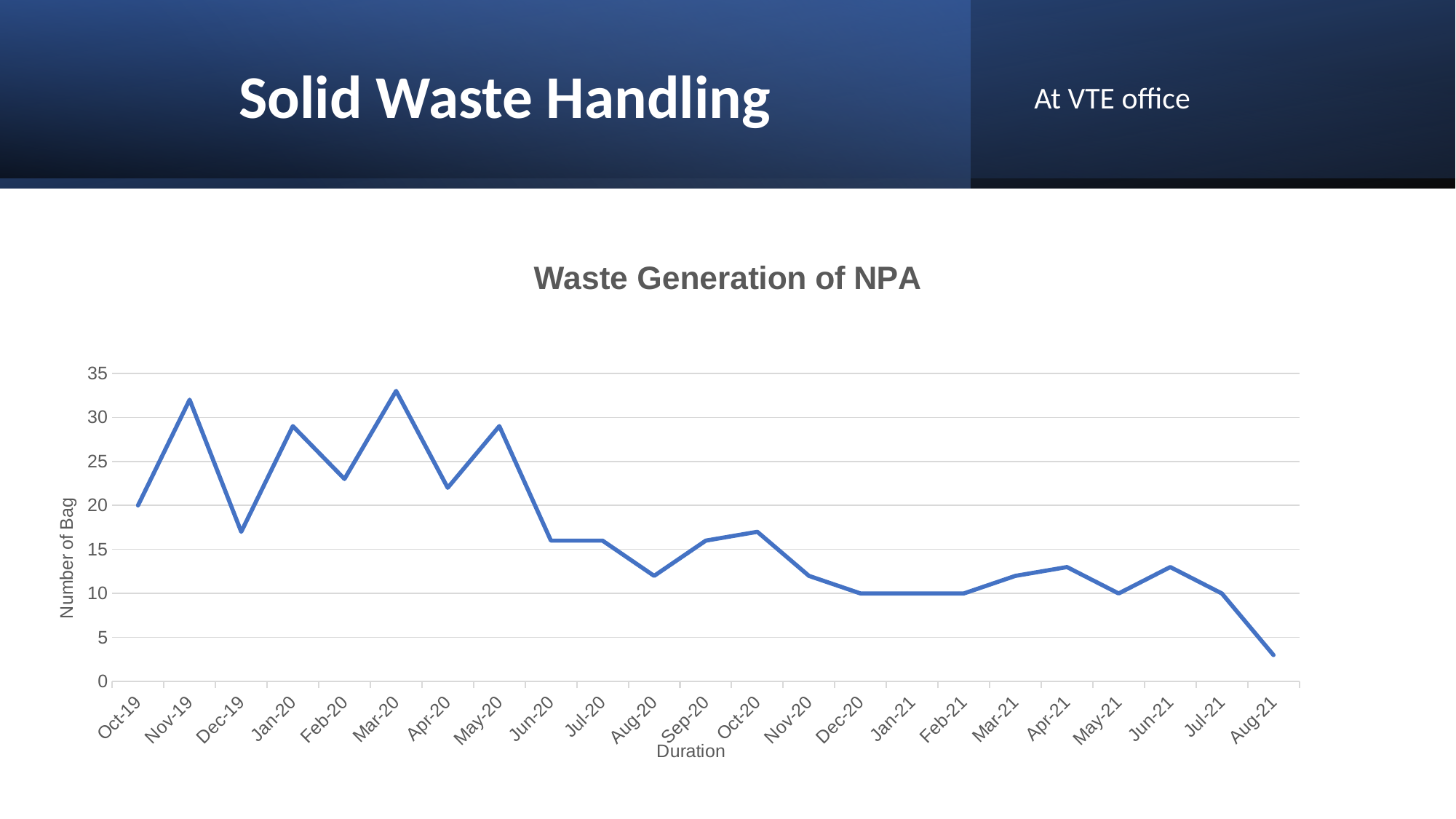
Is the value for Aug-21 greater or less than 5? less What is the title of the chart? Waste Generation of NPA How many months are plotted along the x axis? 23 Which month has the lowest number of bags? Aug-21 Which is larger, the value for Nov-19 or the value for Dec-19? Nov-19 Is the value for Jan-20 greater or less than 25? greater What is the label of the vertical axis? Number of Bag What kind of chart is shown on the slide? line chart Is the value for Nov-19 greater or less than 30? greater Overall, do the values rise or fall from Oct-19 to Aug-21? fall Which is larger, the value for Jun-21 or the value for Aug-21? Jun-21